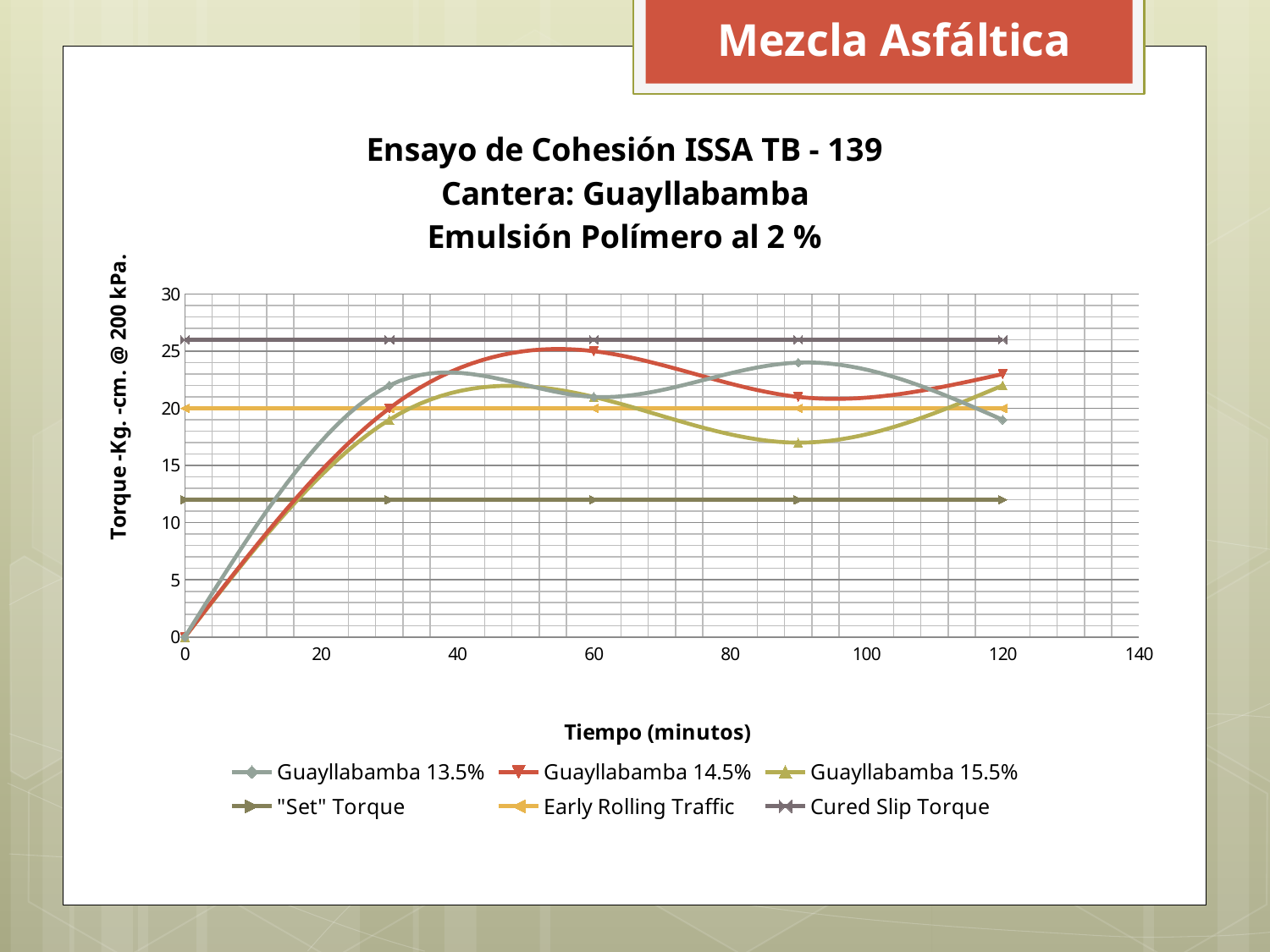
At 60 minutes, which is higher: Guayllabamba 14.5% or Guayllabamba 15.5%? Guayllabamba 14.5% At 90 minutes, which is higher: Guayllabamba 13.5% or Guayllabamba 15.5%? Guayllabamba 13.5% Does the Guayllabamba 15.5% line rise or fall between 0 and 30 minutes? rise Is the value of the Cured Slip Torque line greater or less than 25? greater Which of the three horizontal reference lines has the highest value? Cured Slip Torque Is the value of the "Set" Torque line greater or less than 15? less Is the value for Guayllabamba 14.5% at 60 minutes greater or less than 20? greater What kind of chart is shown on the slide? line chart What is the title of the x axis? Tiempo (minutos) What is the constant torque value of the Early Rolling Traffic line? 20 How many series does the legend list? 6